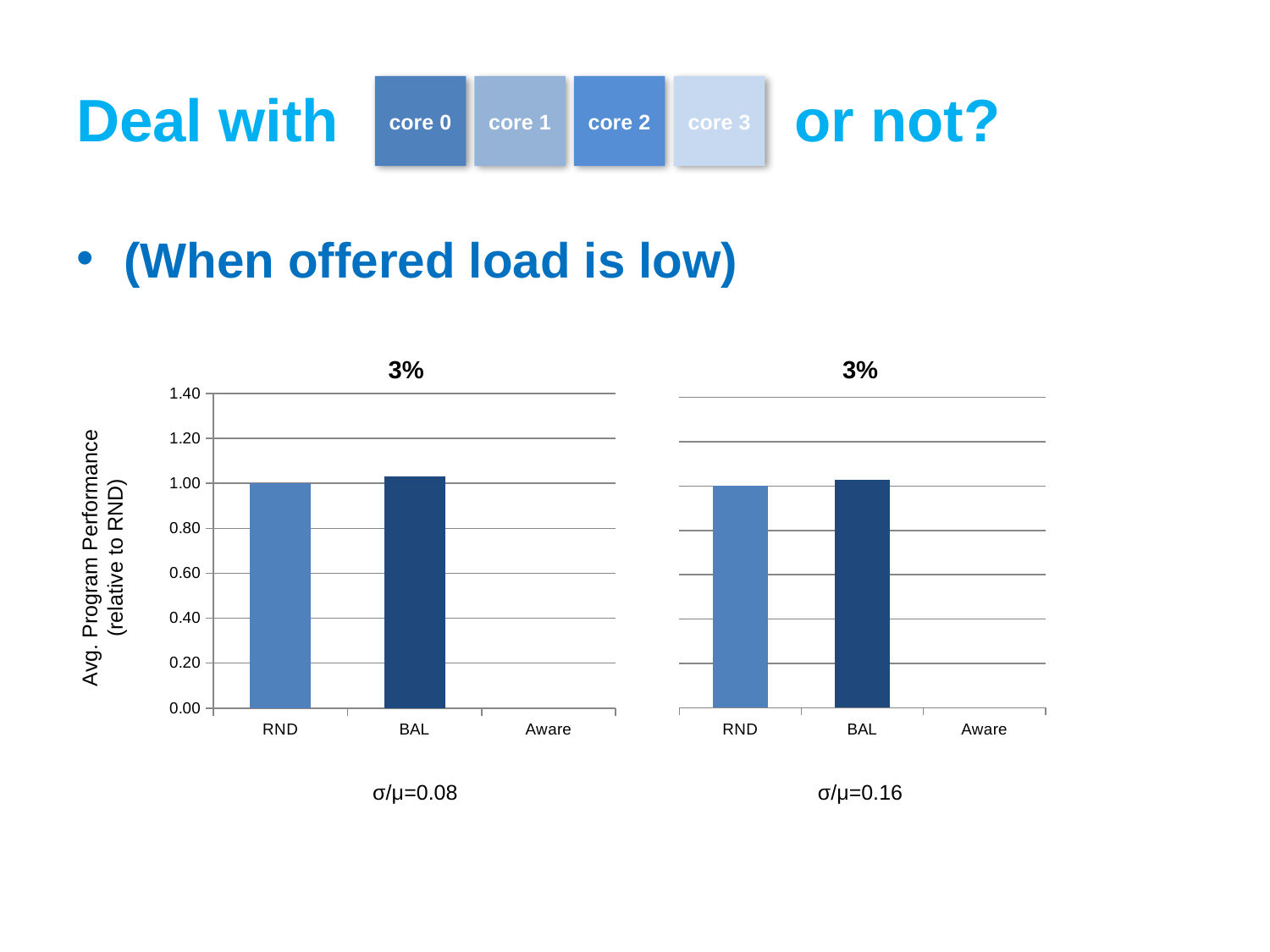
In the left chart (σ/μ=0.08), which category has no bar plotted? Aware What is the y-axis label of the left chart (σ/μ=0.08)? Avg. Program Performance (relative to RND) How many categories are shown on the x axis of the right chart (σ/μ=0.16)? 3 What is the title shown above the right chart (σ/μ=0.16)? 3% In the left chart (σ/μ=0.08), which is larger, RND or BAL? BAL In the right chart (σ/μ=0.16), is the value for RND greater or less than 0.80? greater In the right chart (σ/μ=0.16), is the value for BAL greater or less than 1.00? greater In the right chart (σ/μ=0.16), which is larger, RND or BAL? BAL In the left chart (σ/μ=0.08), what is the value for RND? 1.00 What kind of chart is the left chart (σ/μ=0.08)? bar chart In the left chart (σ/μ=0.08), is the value for BAL greater or less than 1.00? greater